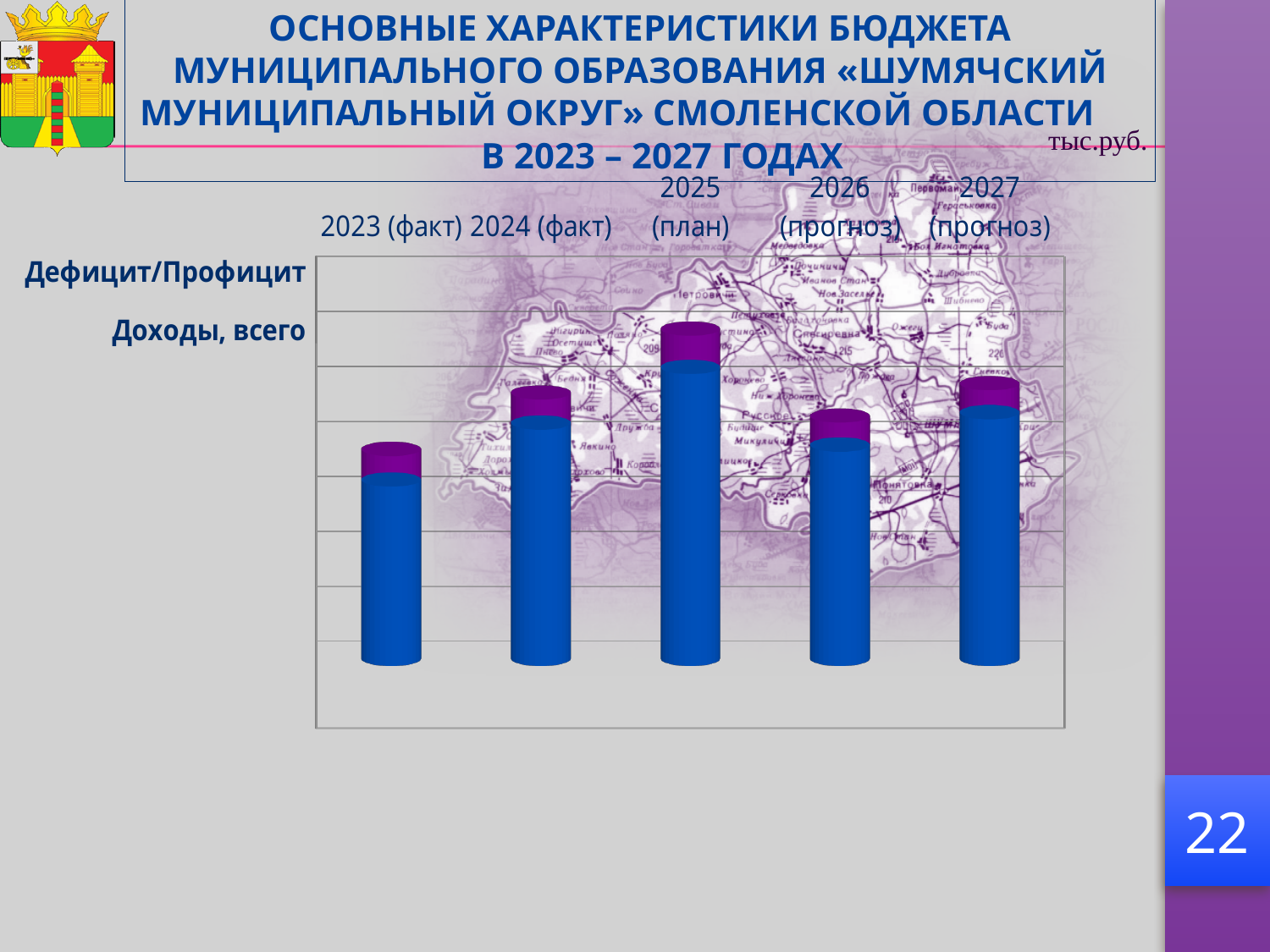
What unit of measurement is indicated for the chart? тыс.руб. Which year has the shortest bar on the chart? 2023 (факт) How many year categories are plotted on the chart? 5 Which bar is taller, 2025 (план) or 2026 (прогноз)? 2025 (план) Which bar is taller, 2023 (факт) or 2024 (факт)? 2024 (факт) Do the bar heights rise or fall from 2023 (факт) to 2025 (план)? rise Which bar is taller, 2023 (факт) or 2027 (прогноз)? 2027 (прогноз) Which year has the tallest bar on the chart? 2025 (план) What kind of chart is shown on the slide? bar chart Do the bar heights rise or fall from 2025 (план) to 2026 (прогноз)? fall